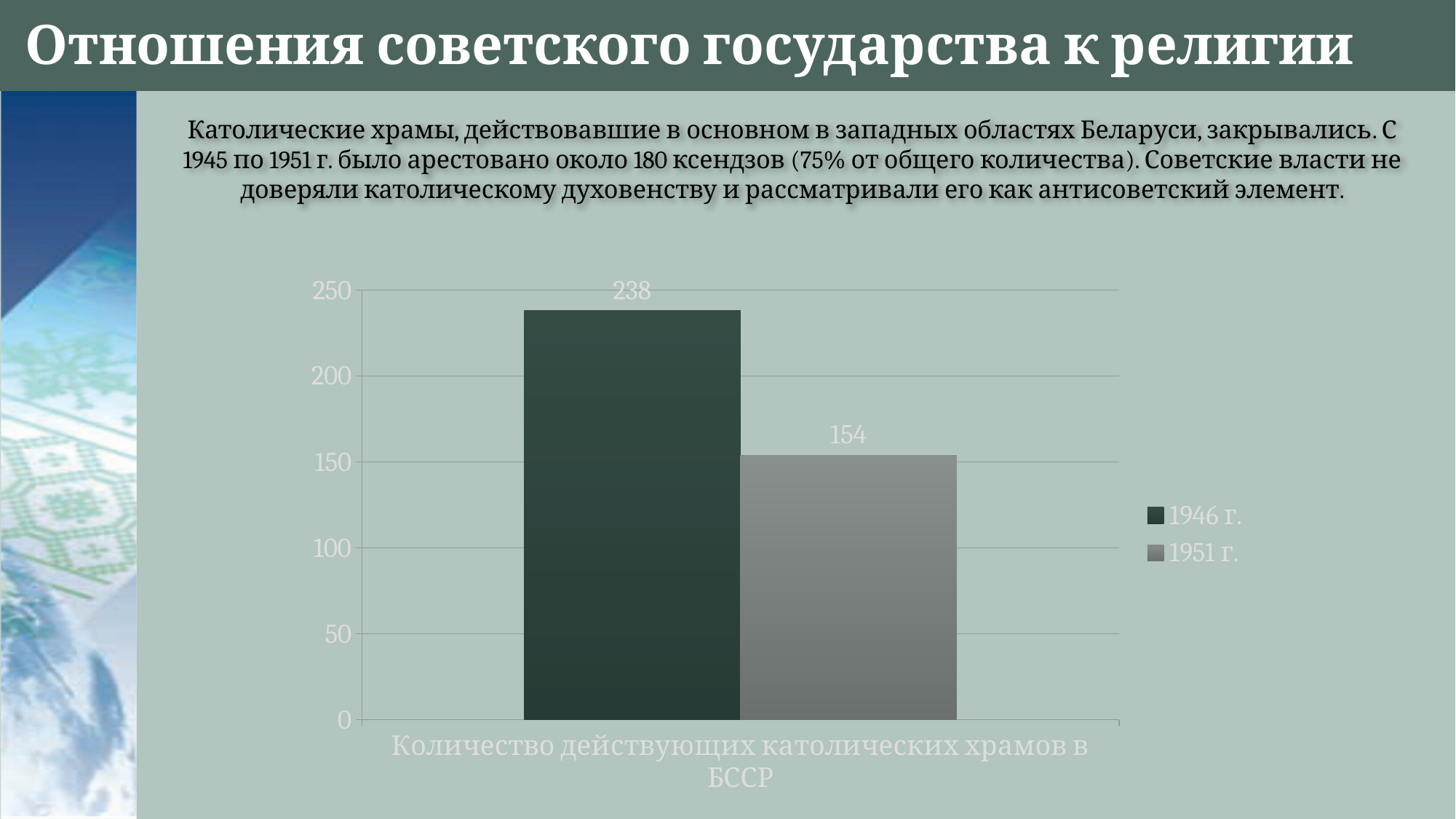
Is the value for 1951 г. greater or less than 200? less How many series does the legend list? 2 What is the highest value shown on the y axis of the chart? 250 What is the difference between the 1946 г. and 1951 г. values? 84 Which series has the lowest value in the chart? 1951 г. Which series has the higher value, 1946 г. or 1951 г.? 1946 г. What kind of chart is shown on the slide? bar chart What is the category label on the x axis of the chart? Количество действующих католических храмов в БССР How many categories are shown on the x axis? 1 What is the value for 1951 г. in the chart? 154 Is the value for 1946 г. greater or less than 200? greater What is the value for 1946 г. in the chart? 238